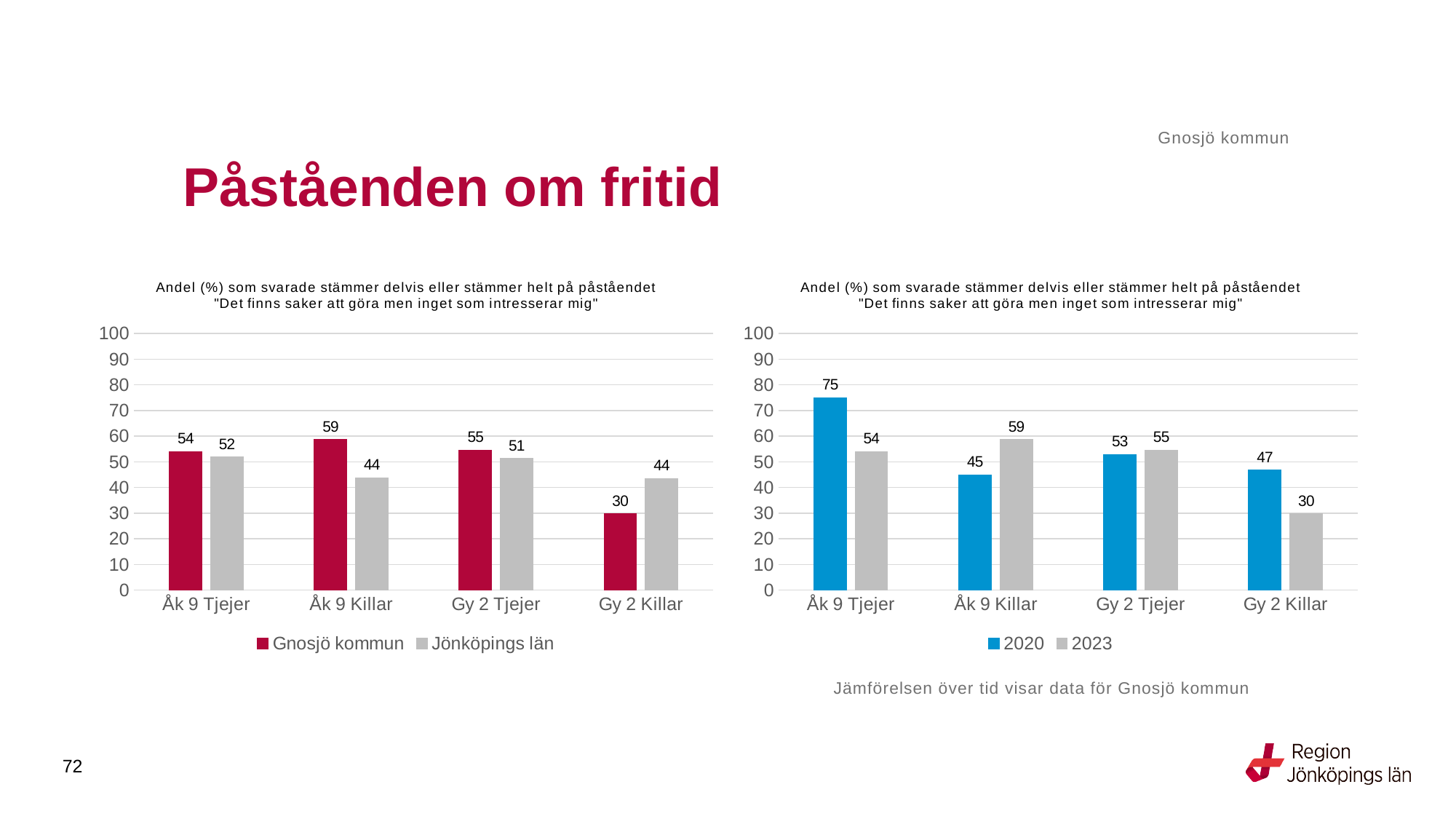
In the right chart, what is the difference between 2020 and 2023 for Åk 9 Tjejer? 21 How many categories are shown on the x axis of the left chart? 4 In the left chart, what is the value for Jönköpings län for Gy 2 Tjejer? 51 In the right chart, what is the value for 2020 for Åk 9 Tjejer? 75 What kind of chart is the left chart? Bar chart In the right chart, what is the value for 2023 for Gy 2 Killar? 30 In the right chart, which is larger for Åk 9 Killar: 2020 or 2023? 2023 In the left chart, which category has the lowest value for Gnosjö kommun? Gy 2 Killar In the left chart, what is the value for Gnosjö kommun for Åk 9 Killar? 59 In the right chart, which category has the highest value for 2020? Åk 9 Tjejer In the left chart, what is the difference between Gnosjö kommun and Jönköpings län for Åk 9 Killar? 15 How many series does the legend of the right chart list? 2